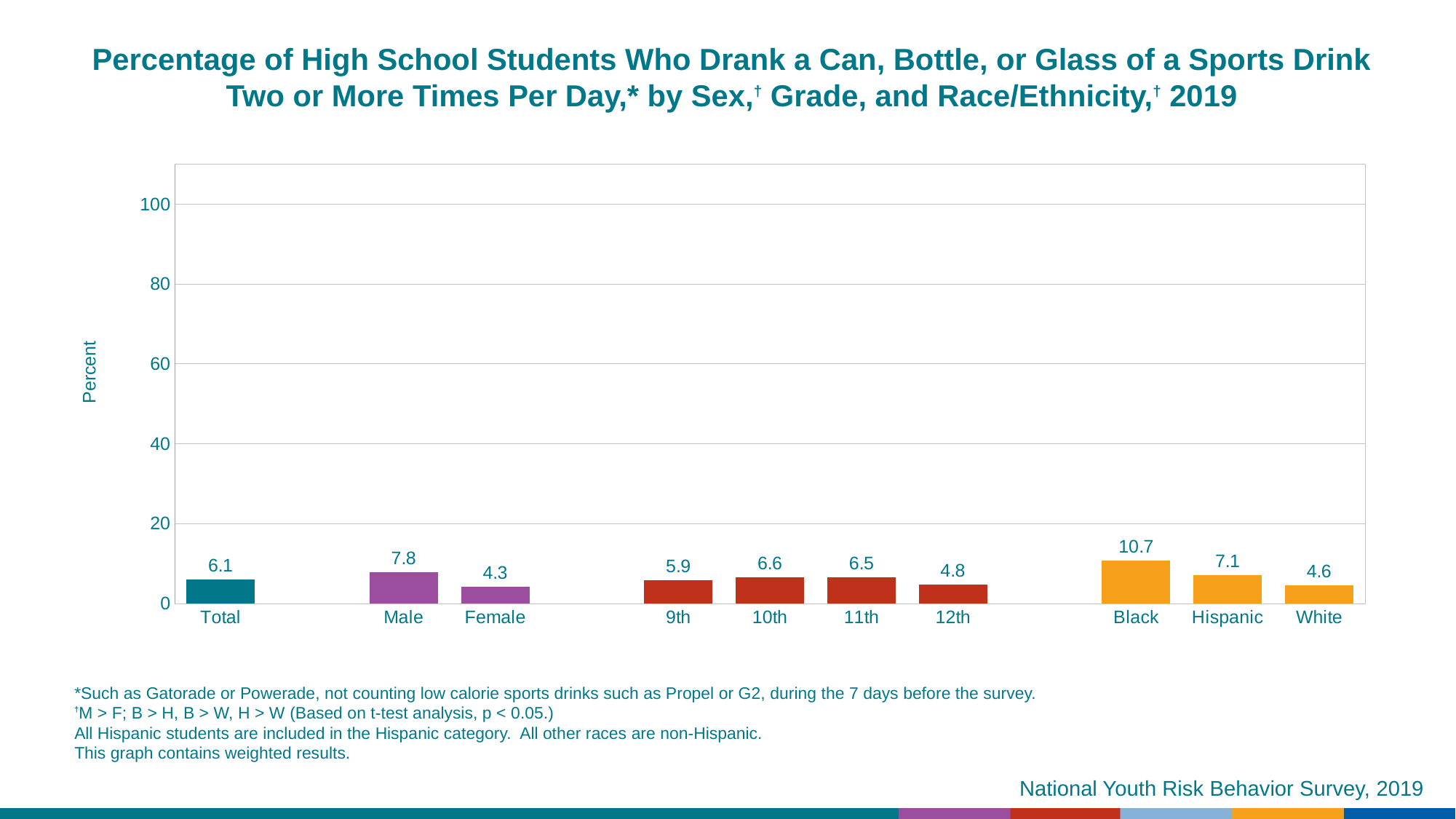
What is the difference between the Black and White values? 6.1 What is the value for 12th grade? 4.8 What kind of chart is this? bar chart Which category has the highest value? Black What is the value for Male? 7.8 What is the difference between the Male and Female values? 3.5 What is the label on the y axis? Percent What is the value for Black students? 10.7 Is the value for Black students greater or less than 20? less Which category has the lowest value? Female How many categories are shown on the x axis? 10 Which is larger, the value for 10th grade or 12th grade? 10th